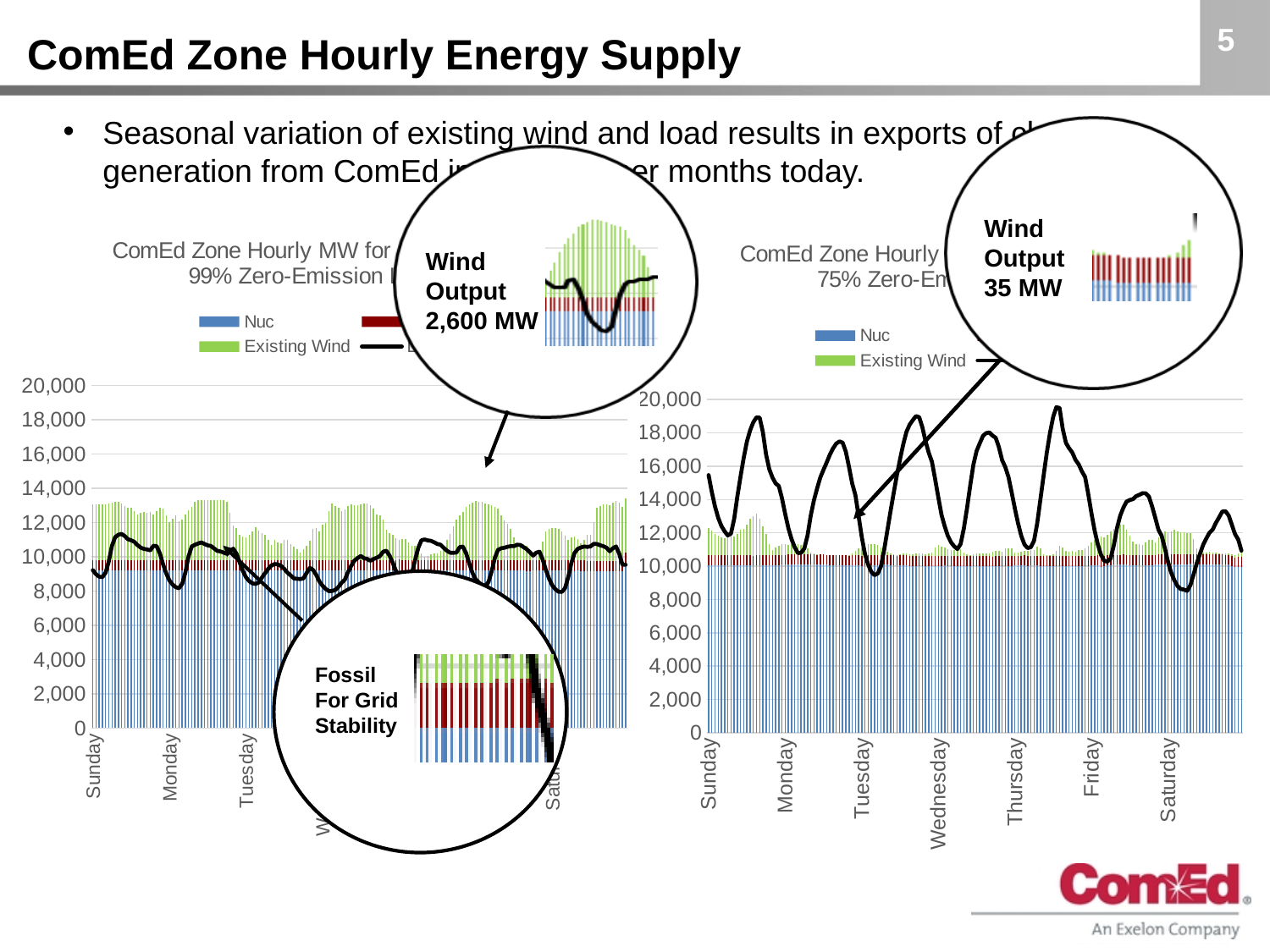
On the right chart, is the peak of the black line on Monday greater or less than 18,000? greater Which colour represents Nuc in the legend of the right chart? blue On the right chart, what is the highest value shown on the vertical axis? 20,000 What kind of chart is the left chart on the slide? bar chart with a line What wind output value is given in the callout pointing to the left chart? 2,600 MW Which callout shows the larger wind output, the one for the left chart or the one for the right chart? the left chart (2,600 MW) What wind output value is given in the callout pointing to the right chart? 35 MW On the left chart, does the black line ever rise above 14,000? No What is the difference between the two wind output values shown in the callouts? 2,565 MW What does the callout in the lower part of the left chart say the red bars are for? Fossil For Grid Stability On the right chart, how many days are labelled along the horizontal axis? 7